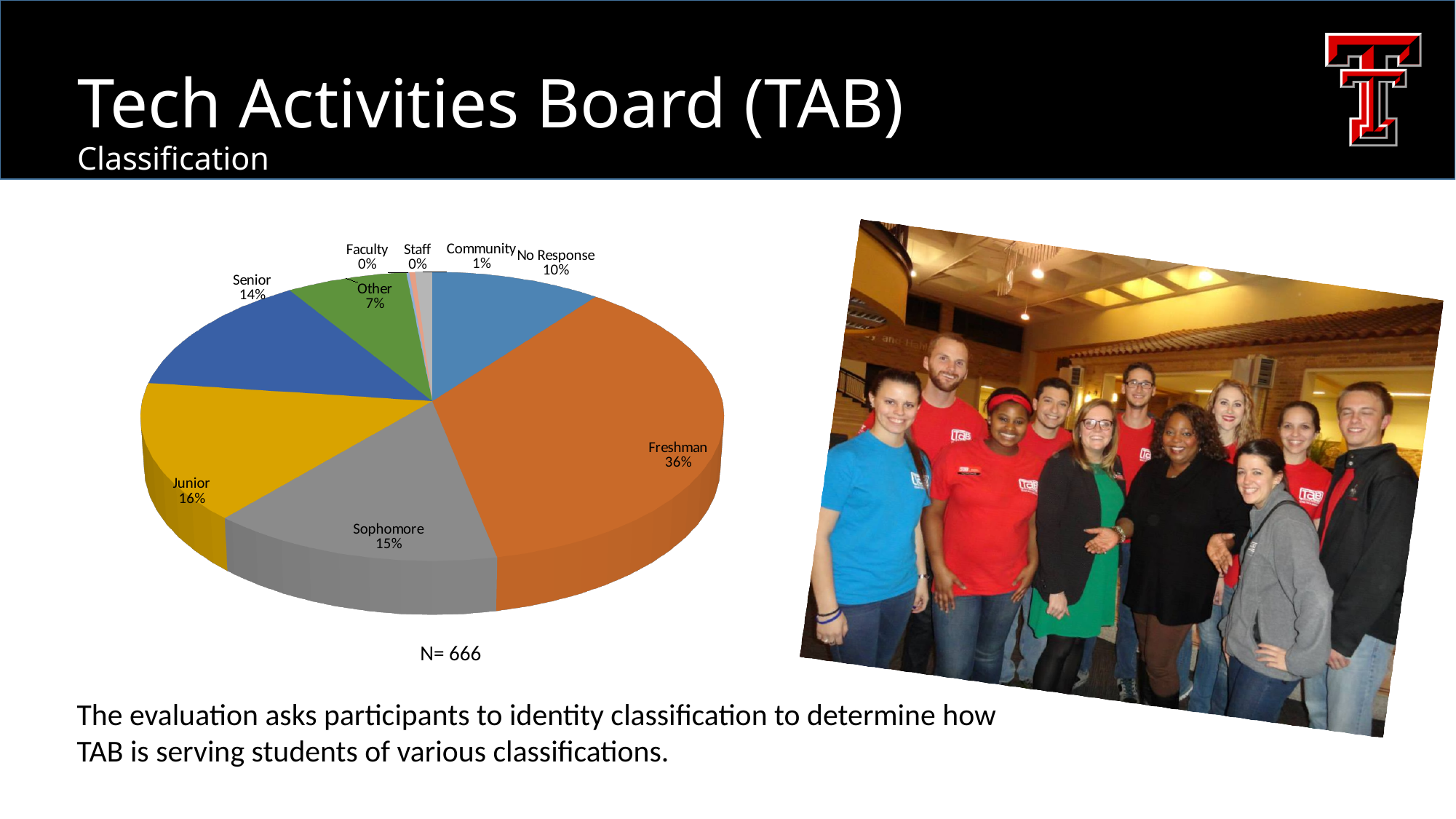
What share of the pie is Freshman? 36% What share of the pie is Community? 1% What share of the pie is No Response? 10% Which is larger, the Junior slice or the Senior slice? Junior What is the value of N shown below the pie chart? N= 666 Which category has the largest slice of the pie? Freshman What is the difference in percentage points between the Freshman and Sophomore slices? 21 What kind of chart is shown on the slide? pie chart How many categories are labelled on the pie chart? 9